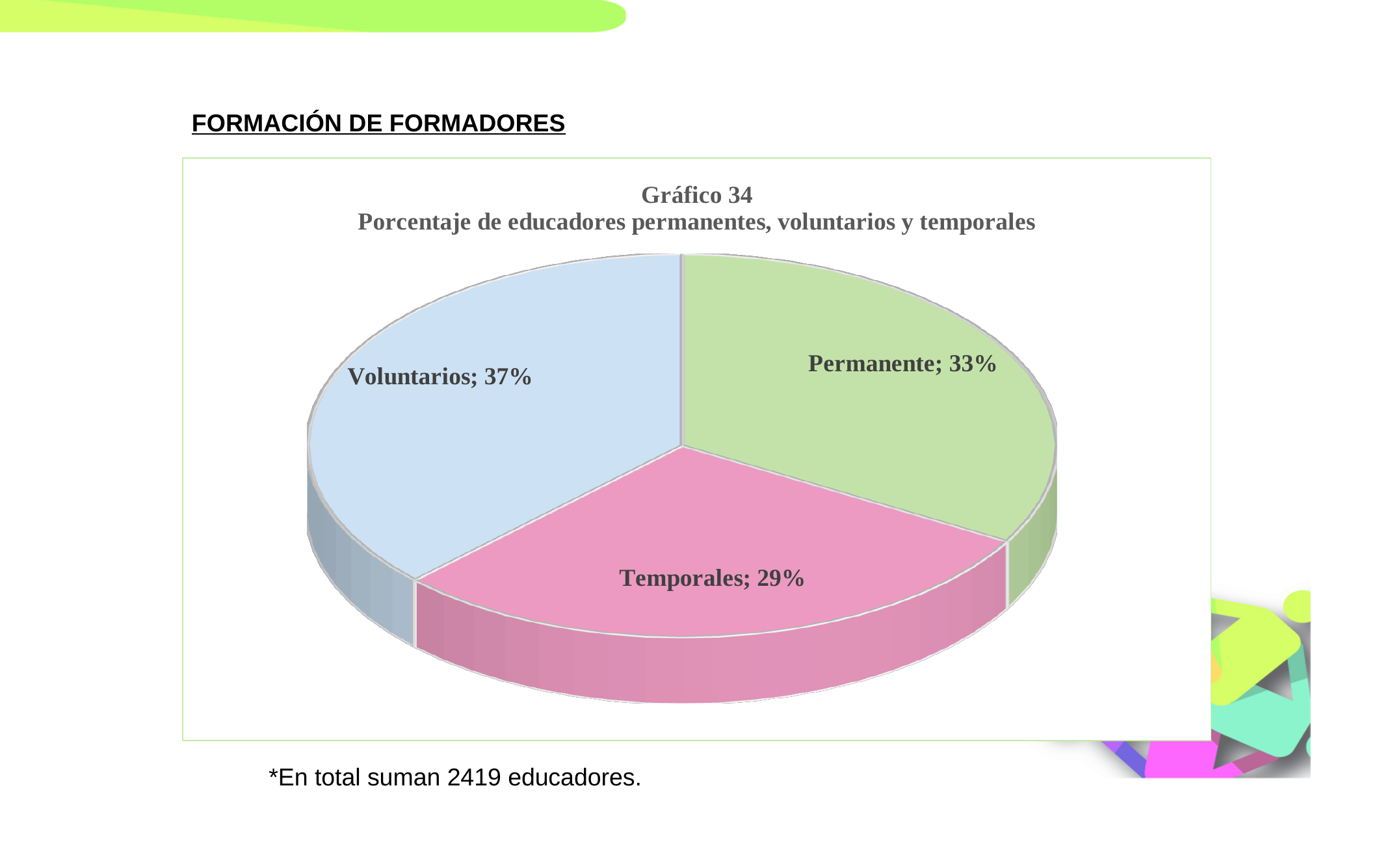
What is the difference in percentage points between Voluntarios and Permanente? 4 Which category has the smallest share of the pie? Temporales Which category has the largest share of the pie? Voluntarios What colour is the Temporales slice? Pink What percentage of educators are Permanente? 33% What is the title of the chart? Gráfico 34 Porcentaje de educadores permanentes, voluntarios y temporales What is the difference in percentage points between Voluntarios and Temporales? 8 Which is larger, the share for Permanente or the share for Temporales? Permanente How many categories are shown in the pie chart? 3 What percentage of educators are Temporales? 29% What percentage of educators are Voluntarios? 37% What kind of chart is shown on the slide? Pie chart